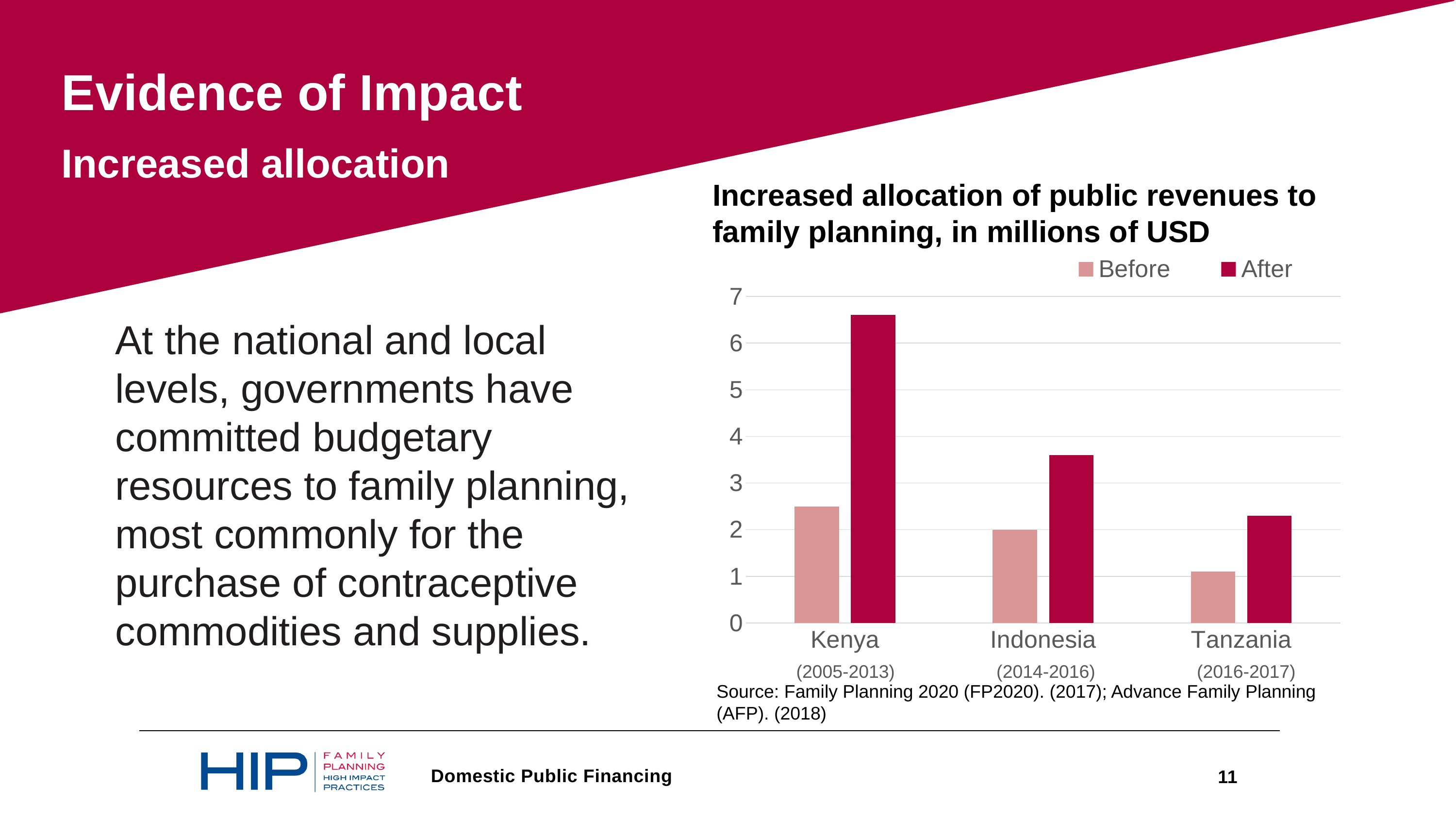
Which legend entry is shown in the darker red colour? After What is the title of the chart? Increased allocation of public revenues to family planning, in millions of USD Which country has the lowest 'Before' value in the chart? Tanzania Is the 'Before' value for Tanzania greater or less than 2? less What kind of chart is shown on the slide? Bar chart Is the 'Before' value for Kenya greater or less than 2? greater Is the 'After' value for Indonesia greater or less than 4? less How many countries are shown on the x axis of the chart? 3 Which is larger: the 'After' value for Indonesia or the 'After' value for Tanzania? Indonesia How many series does the chart's legend list? 2 Which country has the highest 'After' value in the chart? Kenya